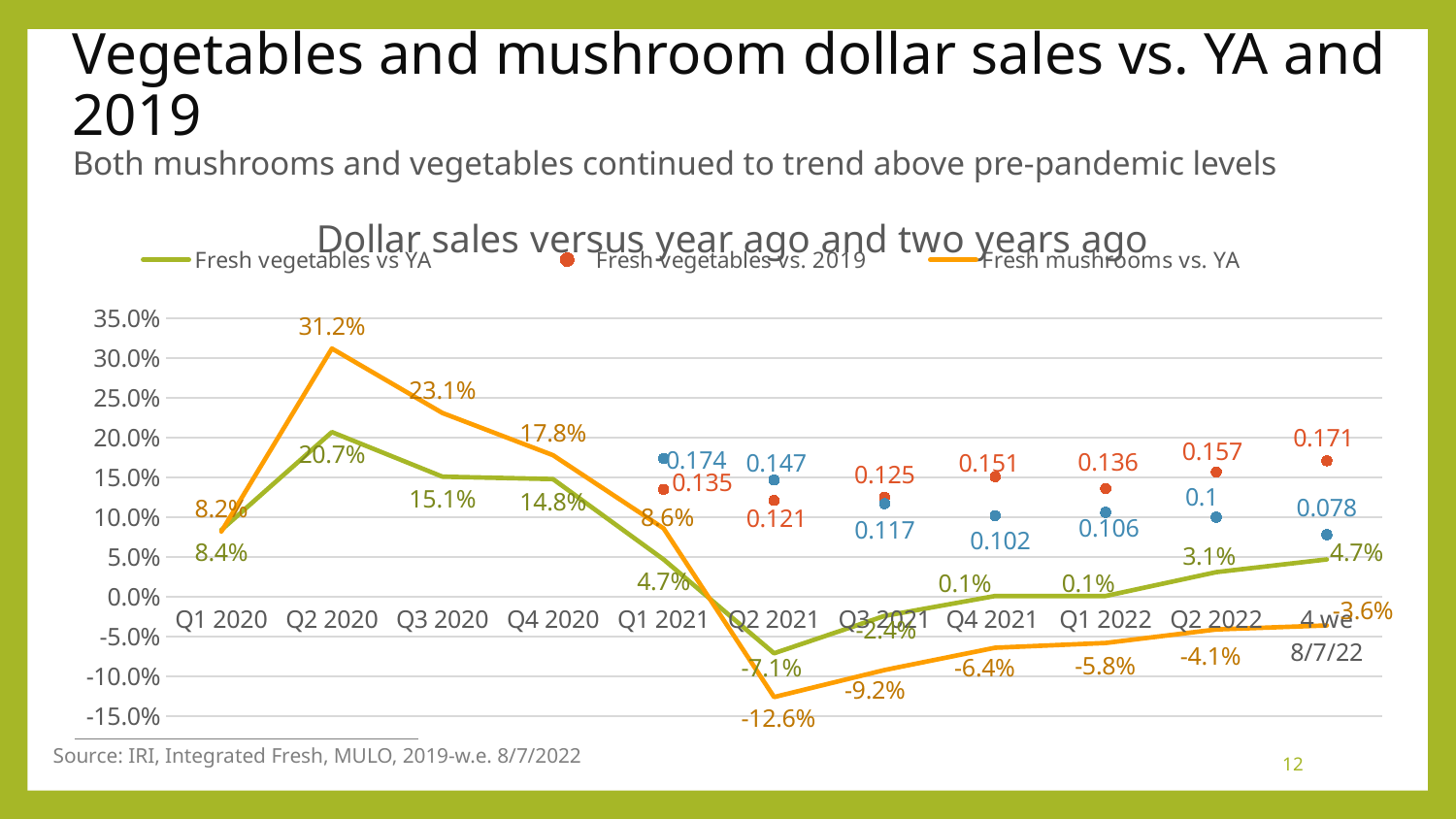
What is the value for Fresh vegetables vs. 2019 at 4 we 8/7/22? 0.171 What is the value for Fresh mushrooms vs. YA in Q2 2020? 31.2% In which period is Fresh vegetables vs. 2019 lowest? Q2 2021 In which quarter is Fresh vegetables vs YA lowest? Q2 2021 Which is larger in Q3 2020: Fresh vegetables vs YA or Fresh mushrooms vs. YA? Fresh mushrooms vs. YA Does Fresh mushrooms vs. YA rise or fall from Q2 2021 to 4 we 8/7/22? Rise In which quarter is Fresh mushrooms vs. YA highest? Q2 2020 What kind of chart is shown on the slide? Line chart How many series does the legend list? 3 What is the value for Fresh vegetables vs YA in Q2 2021? -7.1% How many time periods are shown on the x axis? 11 What is the difference between Fresh mushrooms vs. YA and Fresh vegetables vs YA in Q2 2020? 10.5 percentage points